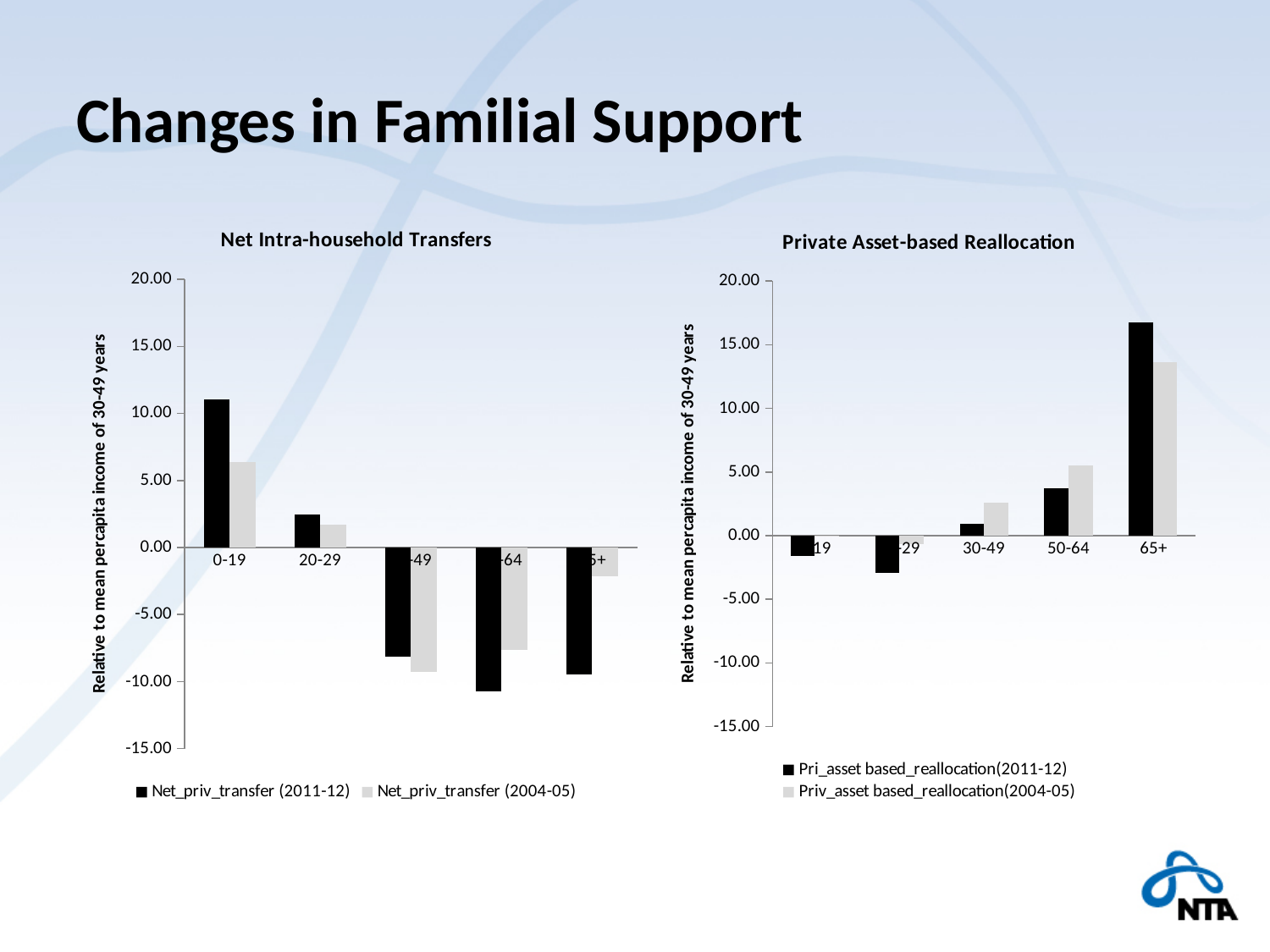
In the 'Net Intra-household Transfers' chart, is the Net_priv_transfer (2011-12) value for 0-19 greater or less than 10.00? greater In the 'Private Asset-based Reallocation' chart, do the Pri_asset based_reallocation(2011-12) values rise or fall from 30-49 to 65+? rise What kind of chart is the 'Net Intra-household Transfers' chart? bar chart In the 'Net Intra-household Transfers' chart, which age group has the highest value for Net_priv_transfer (2011-12)? 0-19 In the 'Private Asset-based Reallocation' chart, is the Pri_asset based_reallocation(2011-12) value for 65+ greater or less than 15.00? greater In the 'Net Intra-household Transfers' chart, for the 0-19 group, which series has the larger value: 2011-12 or 2004-05? 2011-12 In the 'Private Asset-based Reallocation' chart, how many age-group categories are shown on the x axis? 5 In the 'Net Intra-household Transfers' chart, which age group has the lowest value for Net_priv_transfer (2011-12)? 50-64 In the 'Private Asset-based Reallocation' chart, which age group has the highest value for Priv_asset based_reallocation(2004-05)? 65+ In the 'Private Asset-based Reallocation' chart, for the 65+ group, which series has the larger value: 2011-12 or 2004-05? 2011-12 In the 'Net Intra-household Transfers' chart, what is the legend label of the grey series? Net_priv_transfer (2004-05) In the 'Private Asset-based Reallocation' chart, how many series does the legend list? 2